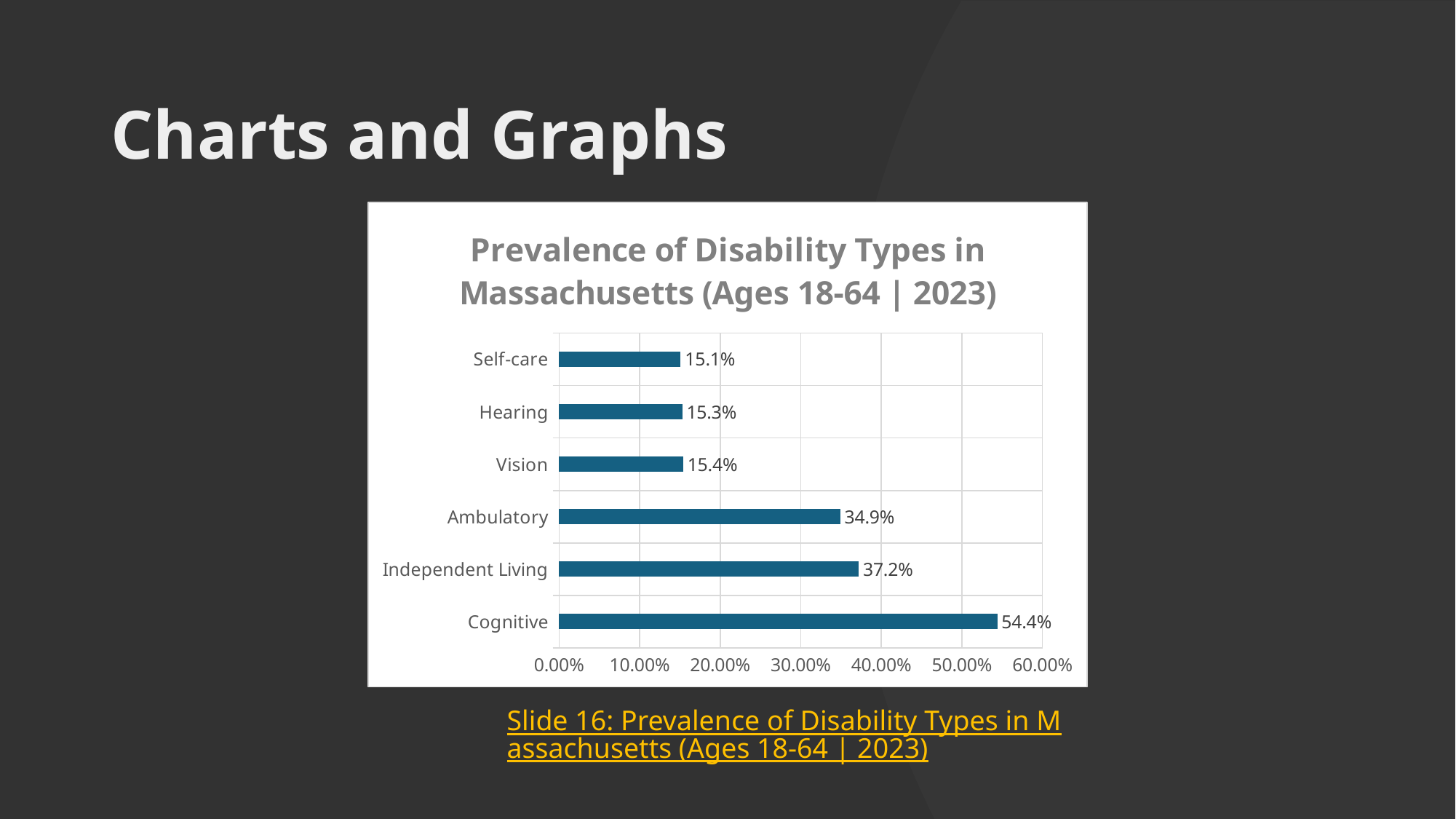
What is the difference between the values for Cognitive and Independent Living? 17.2% What is the value for Cognitive? 54.4% How many disability types are shown in the chart? 6 What is the value for Independent Living? 37.2% Is the value for Cognitive greater or less than 50.00%? greater What is the value for Ambulatory? 34.9% Which is larger, the value for Ambulatory or the value for Self-care? Ambulatory What is the title of the chart? Prevalence of Disability Types in Massachusetts (Ages 18-64 | 2023) What is the difference between the values for Ambulatory and Vision? 19.5% Which disability type has the highest prevalence? Cognitive What is the value for Hearing? 15.3% What kind of chart is shown on the slide? Bar chart